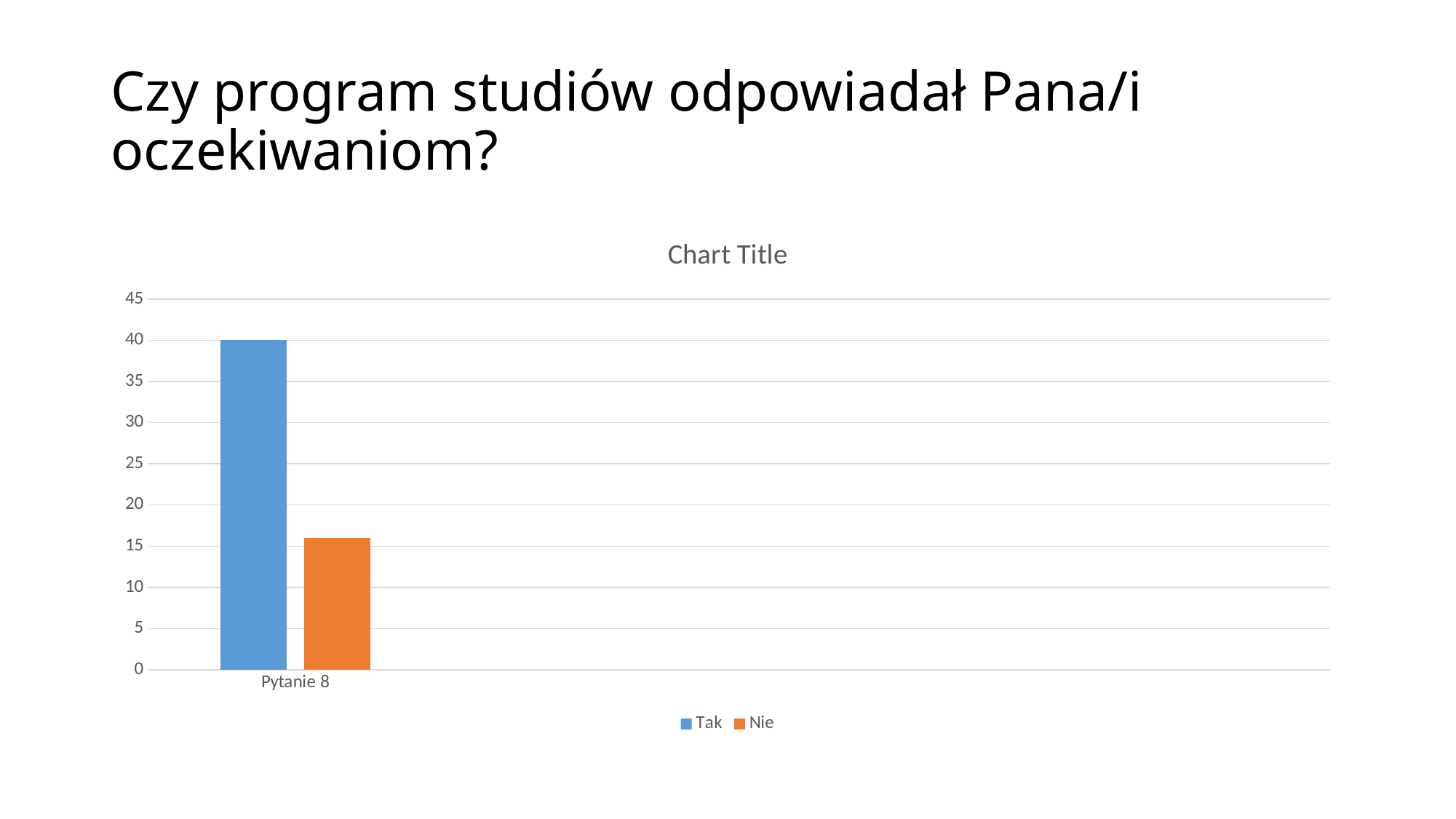
Which series has the highest value in the chart? Tak What colour is the Nie series in the chart? orange How many categories are shown on the x axis? 1 What is the title shown above the chart? Chart Title What is the value of the Tak bar for Pytanie 8? 40 How many series does the legend list? 2 Which series has the lowest value in the chart? Nie What kind of chart is shown on the slide? bar chart Which is larger for Pytanie 8, Tak or Nie? Tak Is the value of the Tak bar for Pytanie 8 greater or less than 35? greater Is the value of the Nie bar for Pytanie 8 greater or less than 20? less